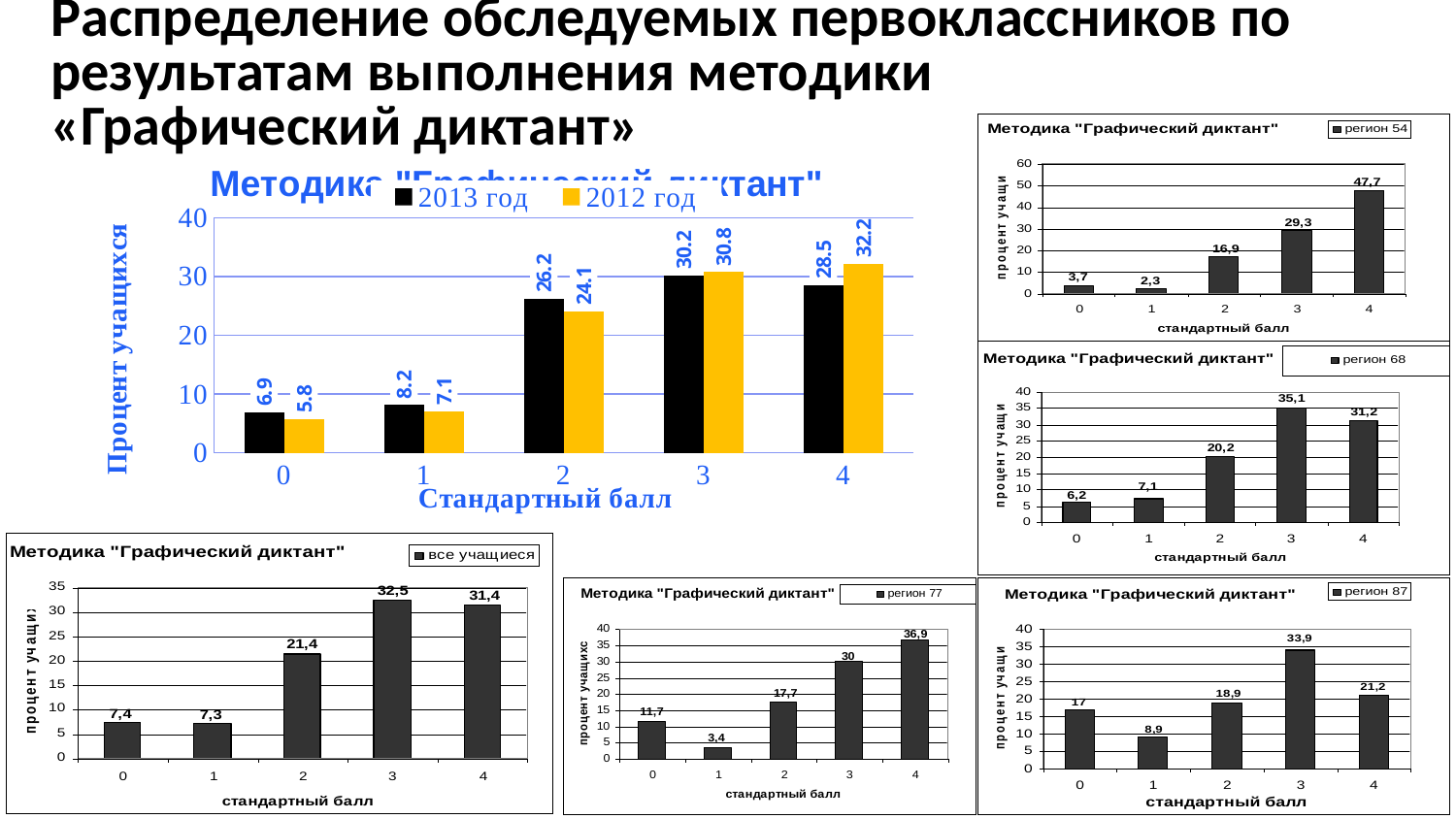
In the chart labelled 'регион 54', what is the value for standard score 1? 2,3 In the chart labelled 'регион 77', which standard score has the lowest percentage? 1 How many categories are shown on the x axis of the chart labelled 'регион 87'? 5 In the large chart with the 2013 and 2012 series, what is the difference between the 2013 and 2012 values at standard score 0? 1.1 In the chart labelled 'регион 68', what is the value for standard score 3? 35,1 In the large chart with the 2013 and 2012 series, how many series does the legend list? 2 In the chart labelled 'регион 87', what is the value for standard score 3? 33,9 In the chart labelled 'регион 68', which is larger: the value for standard score 3 or standard score 4? standard score 3 In the chart labelled 'регион 54', which standard score has the highest percentage? 4 In the large chart with the 2013 and 2012 series, what is the value for 2013 год at standard score 2? 26.2 In the chart labelled 'все учащиеся', what is the value for standard score 2? 21,4 In the large chart with the 2013 and 2012 series, what is the value for 2012 год at standard score 4? 32.2